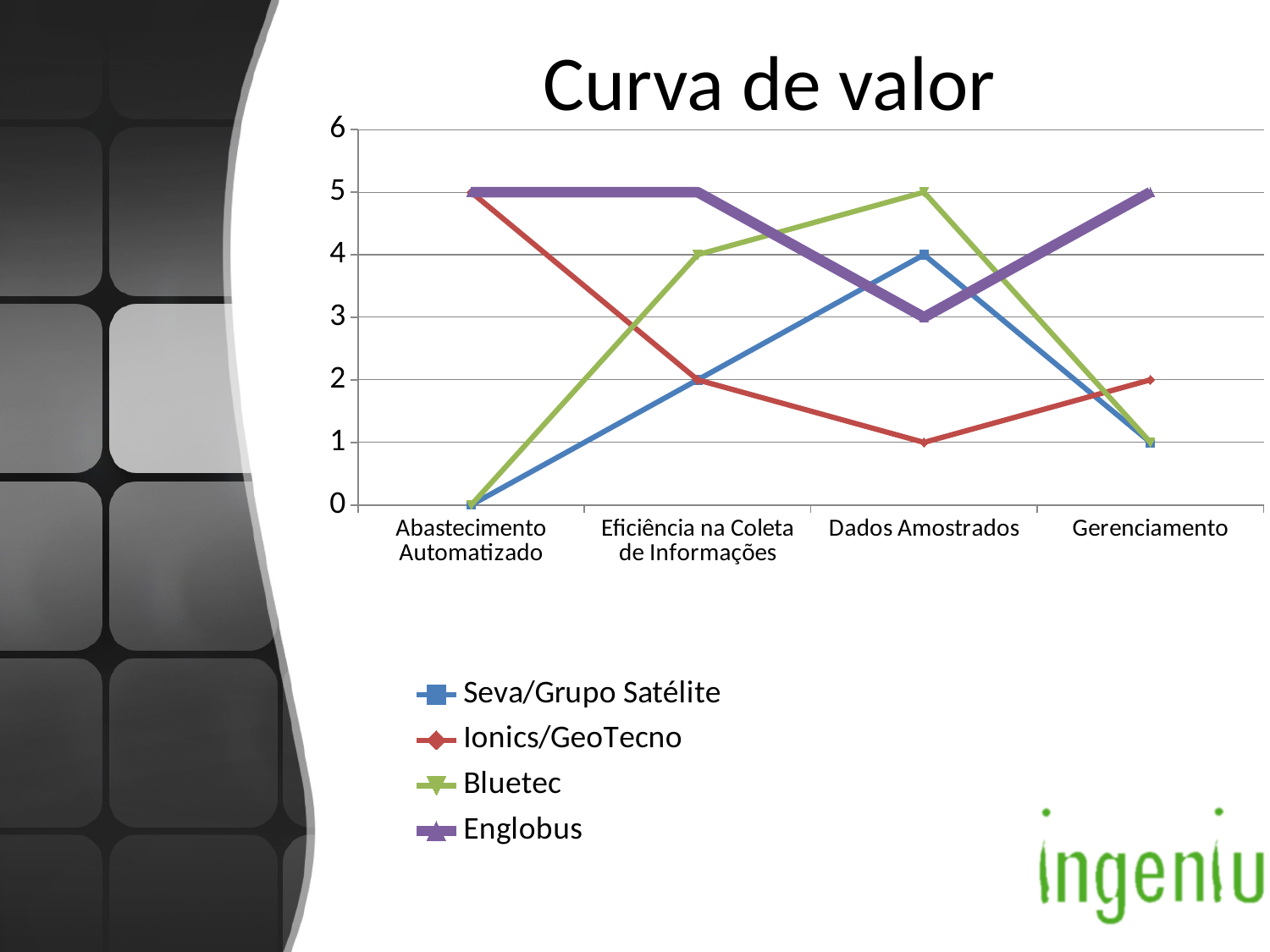
Which series has the highest value at Gerenciamento? Englobus What type of chart is shown on the slide? Line chart What is the title of the chart? Curva de valor What is the value for Ionics/GeoTecno at Abastecimento Automatizado? 5 What is the value for Bluetec at Eficiência na Coleta de Informações? 4 What is the value for Seva/Grupo Satélite at Gerenciamento? 1 What is the difference between Bluetec and Ionics/GeoTecno at Dados Amostrados? 4 What is the value for Englobus at Dados Amostrados? 3 How many series does the legend list? 4 How many categories are shown on the x axis? 4 Which series has the lowest value at Dados Amostrados? Ionics/GeoTecno Does the Ionics/GeoTecno line rise or fall from Abastecimento Automatizado to Dados Amostrados? Fall